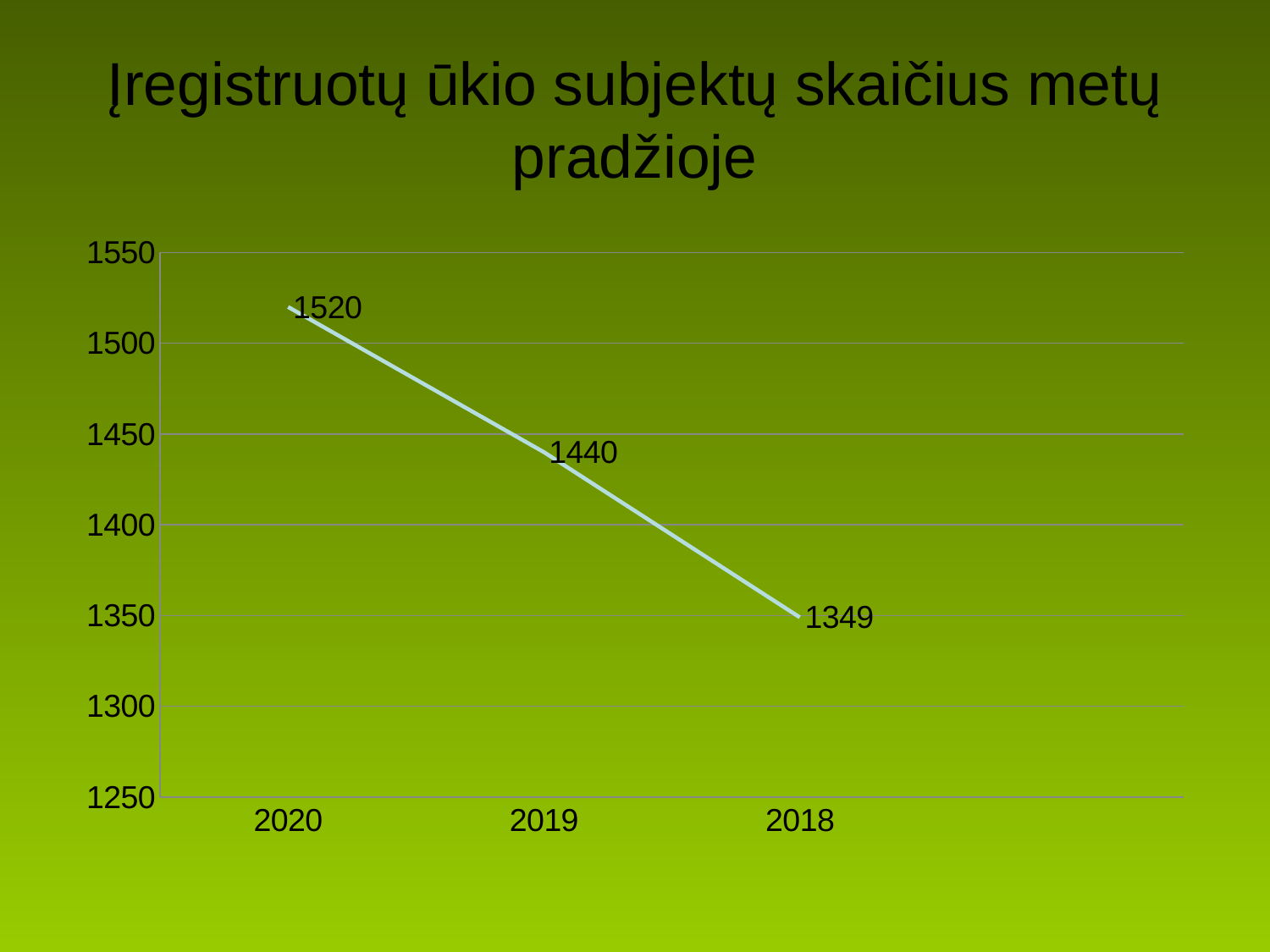
What kind of chart is shown on the slide? line chart How many data points are plotted on the chart? 3 What is the difference between the values for 2020 and 2019? 80 Which is larger, the value for 2019 or the value for 2018? 2019 What is the value for 2018? 1349 Which year has the highest value? 2020 What is the value for 2019? 1440 Which year has the lowest value? 2018 Is the value for 2018 greater or less than 1400? less What is the difference between the values for 2020 and 2018? 171 Do the values rise or fall along the x axis from left to right? fall What is the value for 2020? 1520